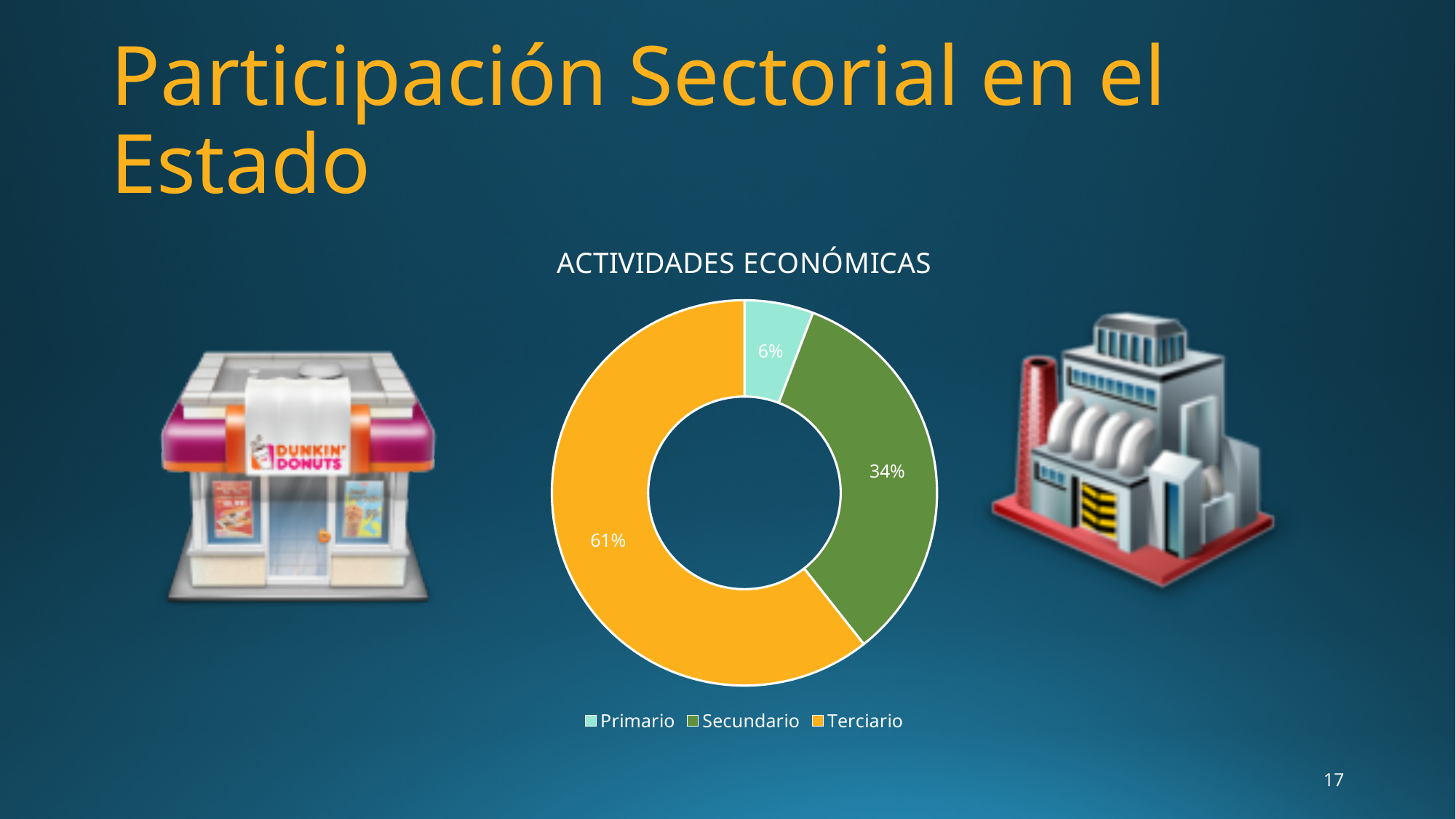
What share of the chart does Secundario represent? 34% What colour is the Terciario slice in the chart? Orange What share of the chart does Terciario represent? 61% How many sectors are shown in the chart? 3 Which sector has the smallest share in the chart? Primario What is the title of the chart? ACTIVIDADES ECONÓMICAS What share of the chart does Primario represent? 6% What is the difference in percentage points between Terciario and Secundario? 27 What kind of chart is shown on the slide? Doughnut chart Which is larger, the share for Secundario or the share for Primario? Secundario What is the difference in percentage points between Secundario and Primario? 28 Which sector has the largest share in the chart? Terciario